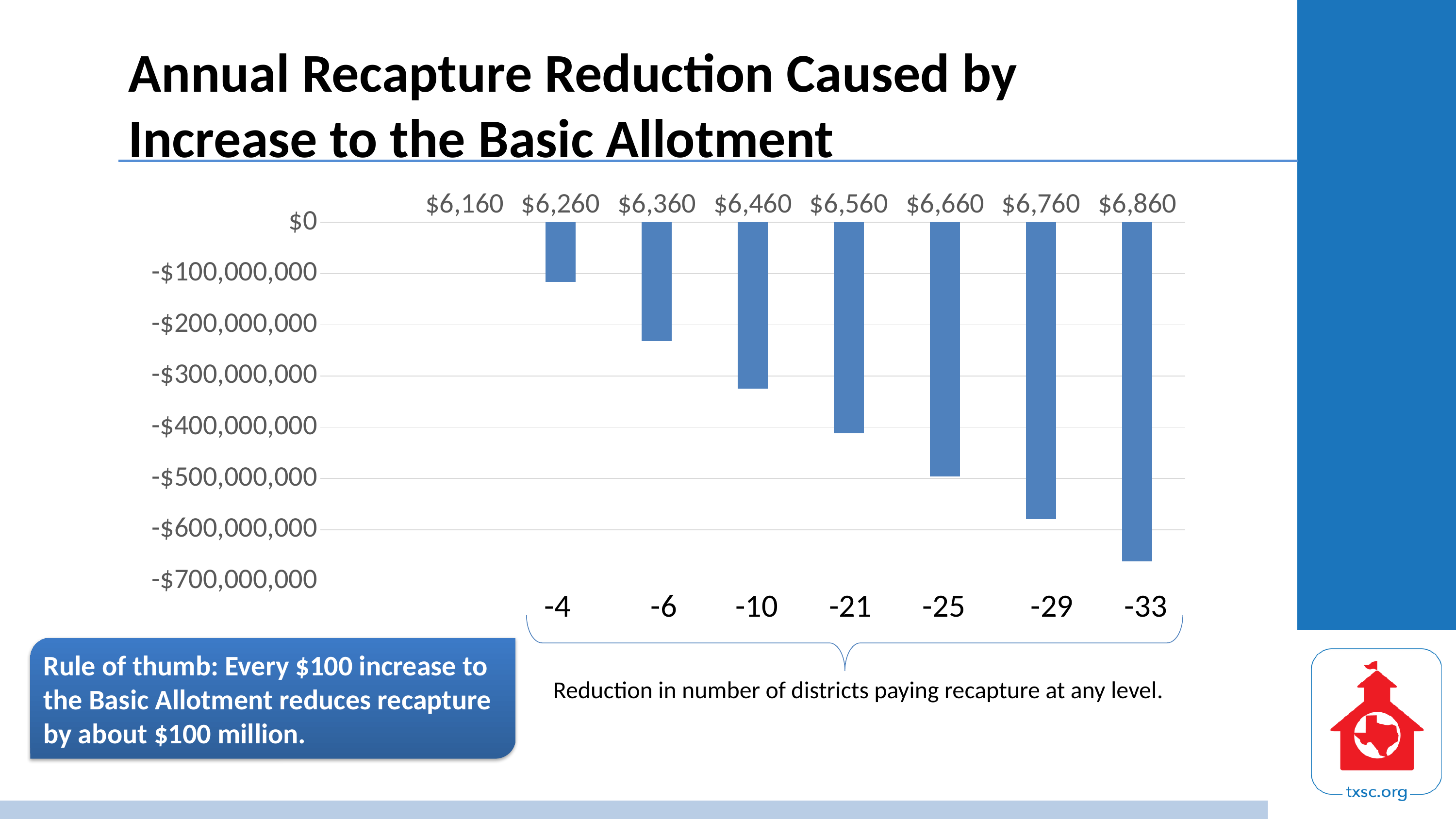
Is the value for $6,860 greater or less than -$700,000,000? greater What kind of chart is shown on the slide? bar chart What is the title of the chart on the slide? Annual Recapture Reduction Caused by Increase to the Basic Allotment Is the value for $6,760 greater or less than -$600,000,000? greater What reduction in the number of districts paying recapture is shown beneath the $6,860 bar? -33 How many Basic Allotment categories are labelled along the top of the chart? 8 Is the value for $6,460 greater or less than -$300,000,000? less Which Basic Allotment category has the lowest (most negative) recapture reduction value? $6,860 Which Basic Allotment category has the shortest visible bar? $6,260 Do the bar values rise or fall as the Basic Allotment increases along the x axis? fall Which has the larger (less negative) value, $6,360 or $6,760? $6,360